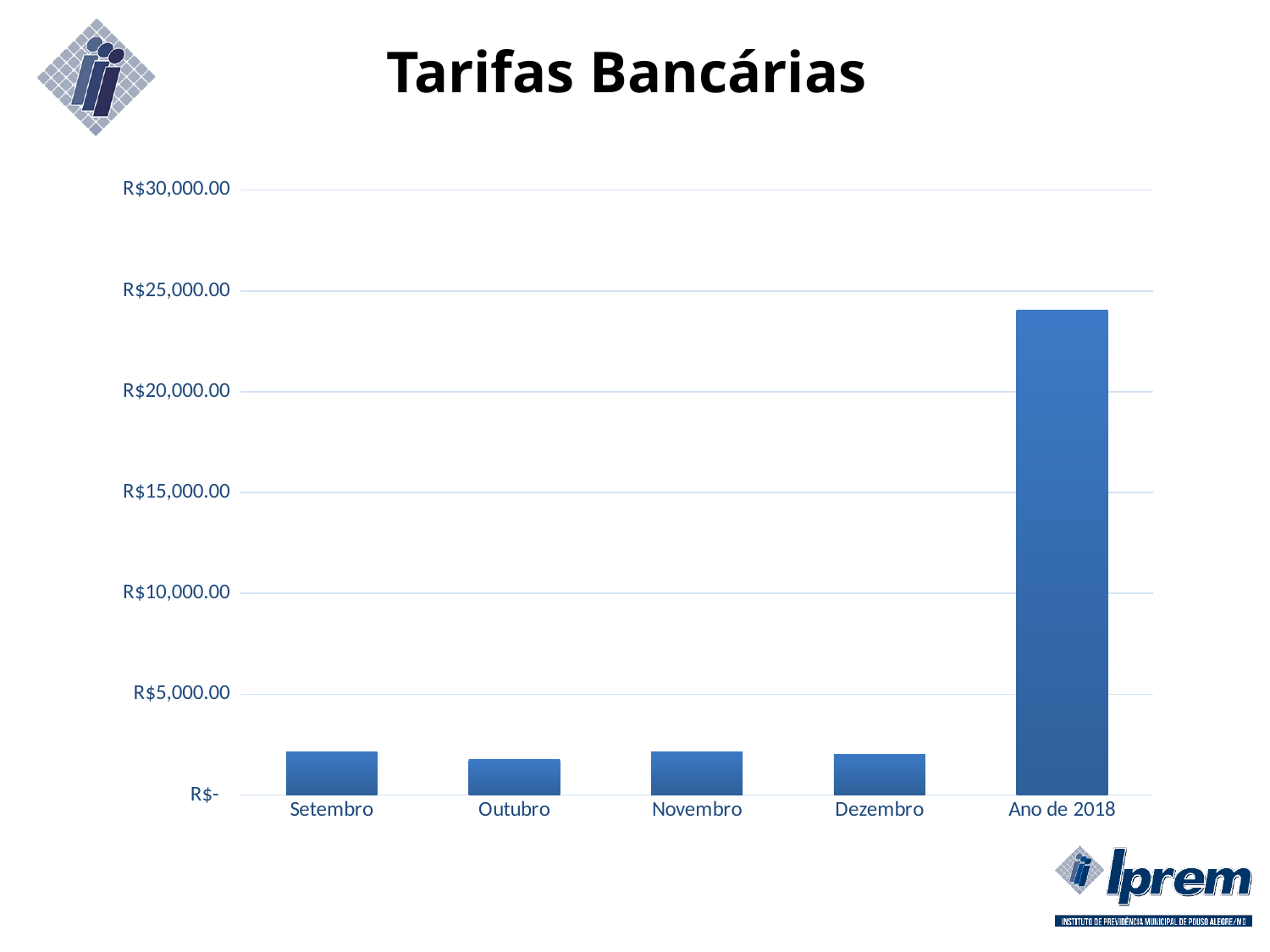
Which category has the lowest value in the chart? Outubro Which is larger, the value for Dezembro or the value for Outubro? Dezembro Is the value for Ano de 2018 greater or less than R$25,000.00? less Is the value for Dezembro greater or less than R$5,000.00? less What is the highest value shown on the y axis of the chart? R$30,000.00 Is the value for Setembro greater or less than R$5,000.00? less What is the title of the chart? Tarifas Bancárias Which category has the highest value in the chart? Ano de 2018 What kind of chart is shown on the slide? bar chart How many categories are shown on the x axis of the chart? 5 Which is larger, the value for Ano de 2018 or the value for Novembro? Ano de 2018